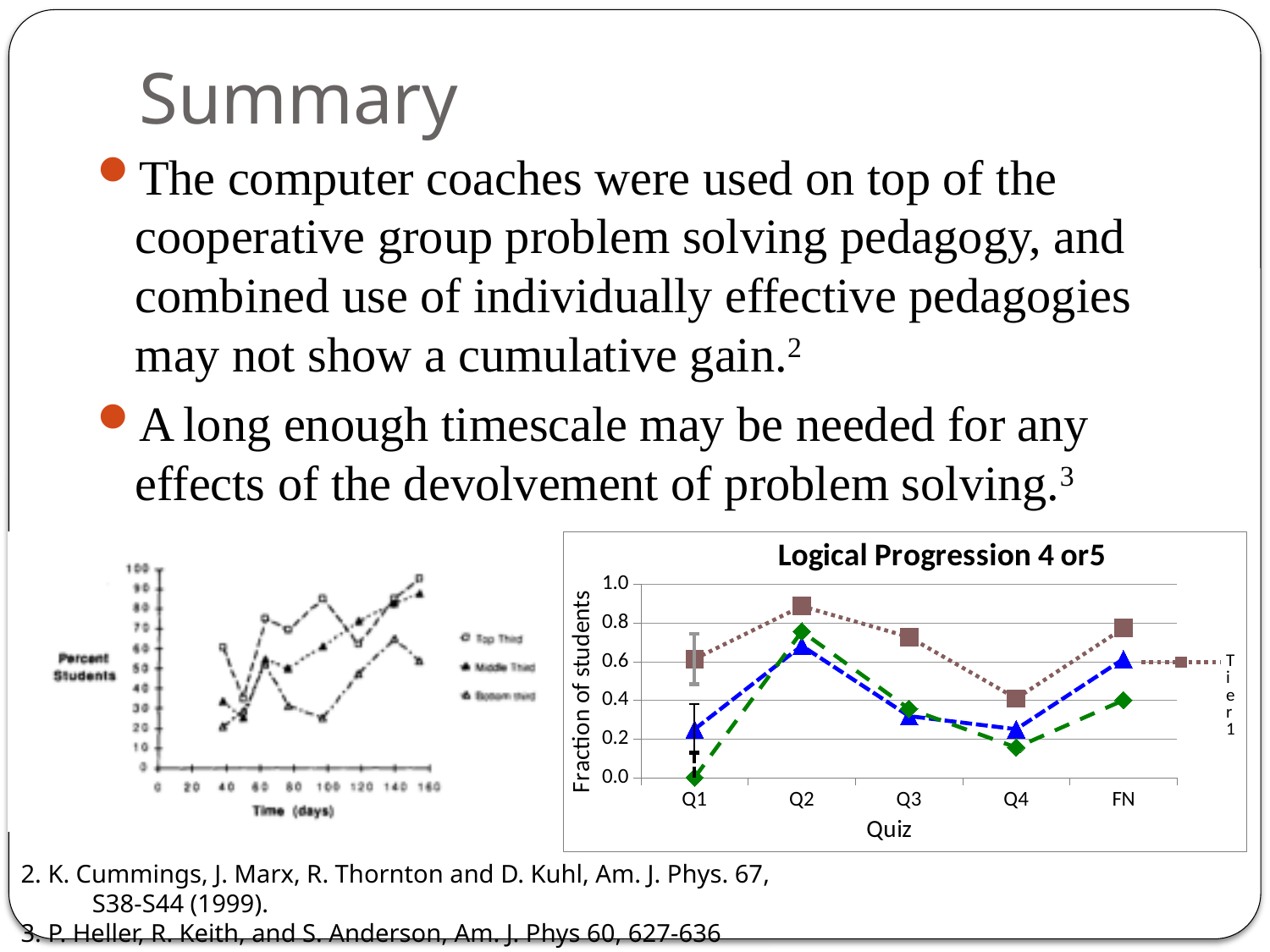
In the 'Logical Progression 4 or5' chart, is the value of the blue triangle-marker series at Q2 greater or less than 0.6? greater In the 'Logical Progression 4 or5' chart, is the value of the green diamond-marker series at Q4 greater or less than 0.2? less In the 'Logical Progression 4 or5' chart, at which quiz does the green diamond-marker series have its lowest value? Q1 What kind of chart is the 'Percent Students' versus 'Time (days)' chart on the left of the slide? line chart In the 'Logical Progression 4 or5' chart, at Q4, which series has the larger value: the brown square-marker series or the green diamond-marker series? the brown square-marker series What is the title of the chart on the right of the slide? Logical Progression 4 or5 How many series does the legend of the left-hand 'Percent Students' chart list? 3 In the 'Logical Progression 4 or5' chart, is the value of the brown square-marker series at Q2 greater or less than 0.8? greater What kind of chart is the 'Logical Progression 4 or5' chart on the right of the slide? line chart In the 'Logical Progression 4 or5' chart, how many quiz categories are shown on the x axis? 5 In the 'Logical Progression 4 or5' chart, at which quiz does the brown square-marker series reach its highest value? Q2 In the 'Logical Progression 4 or5' chart, does the brown square-marker series rise or fall from Q2 to Q4? fall